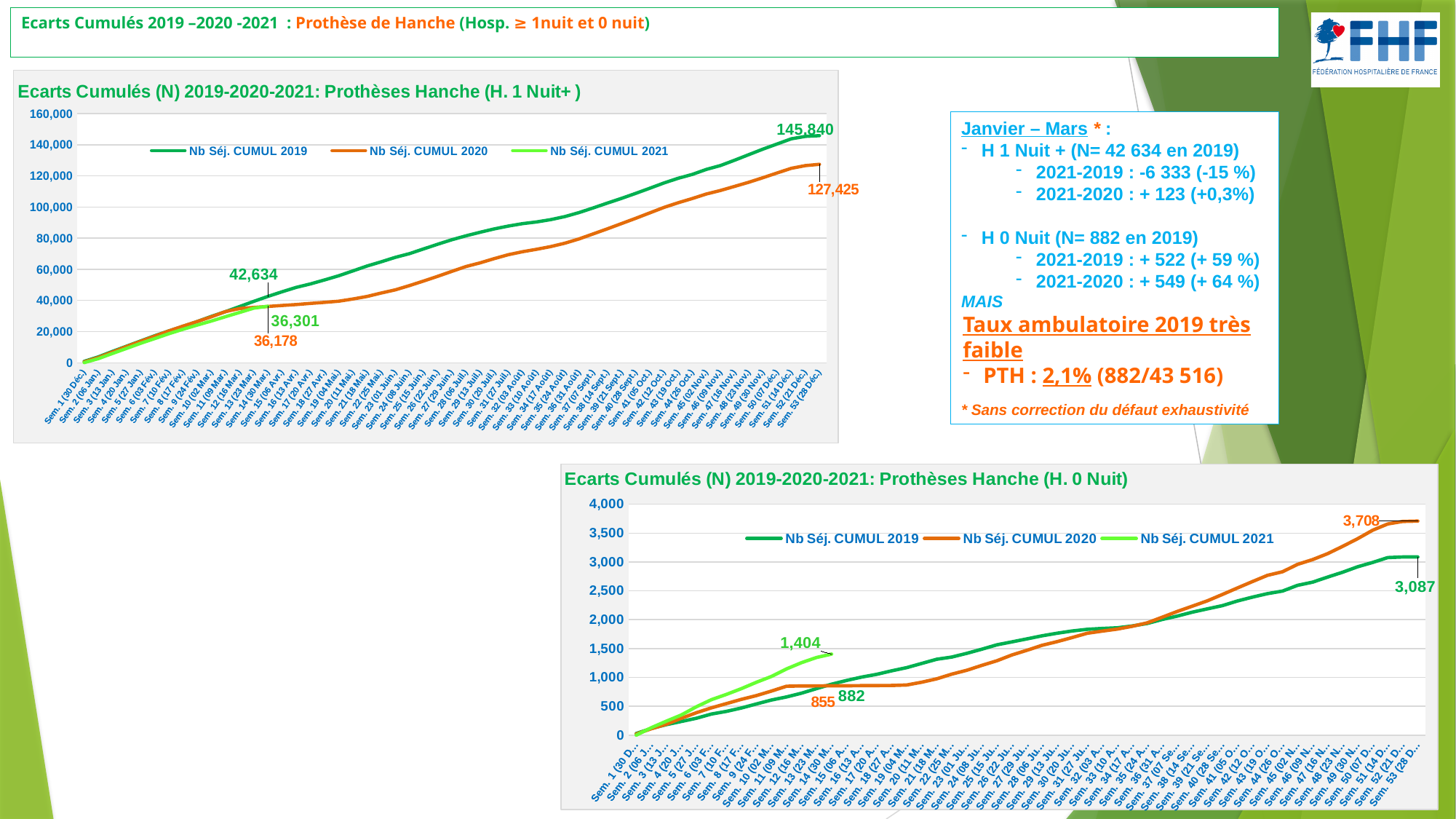
In the chart titled "Ecarts Cumulés (N) 2019-2020-2021: Prothèses Hanche (H. 1 Nuit+ )", what is the final labelled value of the Nb Séj. CUMUL 2020 series? 127,425 In the chart titled "Ecarts Cumulés (N) 2019-2020-2021: Prothèses Hanche (H. 1 Nuit+ )", do the values of the Nb Séj. CUMUL 2019 series rise or fall along the x axis? Rise In the chart titled "Ecarts Cumulés (N) 2019-2020-2021: Prothèses Hanche (H. 0 Nuit)", what is the difference between the final labelled values of the 2020 and 2019 series? 621 In the chart titled "Ecarts Cumulés (N) 2019-2020-2021: Prothèses Hanche (H. 1 Nuit+ )", what is the final labelled value of the Nb Séj. CUMUL 2019 series? 145,840 In the chart titled "Ecarts Cumulés (N) 2019-2020-2021: Prothèses Hanche (H. 1 Nuit+ )", what is the difference between the final labelled values of the 2019 and 2020 series? 18,415 In the chart titled "Ecarts Cumulés (N) 2019-2020-2021: Prothèses Hanche (H. 1 Nuit+ )", what is the labelled value of the Nb Séj. CUMUL 2021 series at its last point? 36,301 In the chart titled "Ecarts Cumulés (N) 2019-2020-2021: Prothèses Hanche (H. 0 Nuit)", what is the final labelled value of the Nb Séj. CUMUL 2020 series? 3,708 In the chart titled "Ecarts Cumulés (N) 2019-2020-2021: Prothèses Hanche (H. 1 Nuit+ )", how many series does the legend list? 3 In the chart titled "Ecarts Cumulés (N) 2019-2020-2021: Prothèses Hanche (H. 0 Nuit)", which series ends with the higher value, Nb Séj. CUMUL 2019 or Nb Séj. CUMUL 2020? Nb Séj. CUMUL 2020 What kind of chart is the chart titled "Ecarts Cumulés (N) 2019-2020-2021: Prothèses Hanche (H. 0 Nuit)"? Line chart In the chart titled "Ecarts Cumulés (N) 2019-2020-2021: Prothèses Hanche (H. 0 Nuit)", what is the final labelled value of the Nb Séj. CUMUL 2019 series? 3,087 In the chart titled "Ecarts Cumulés (N) 2019-2020-2021: Prothèses Hanche (H. 0 Nuit)", what is the labelled value of the Nb Séj. CUMUL 2021 series at its last point? 1,404